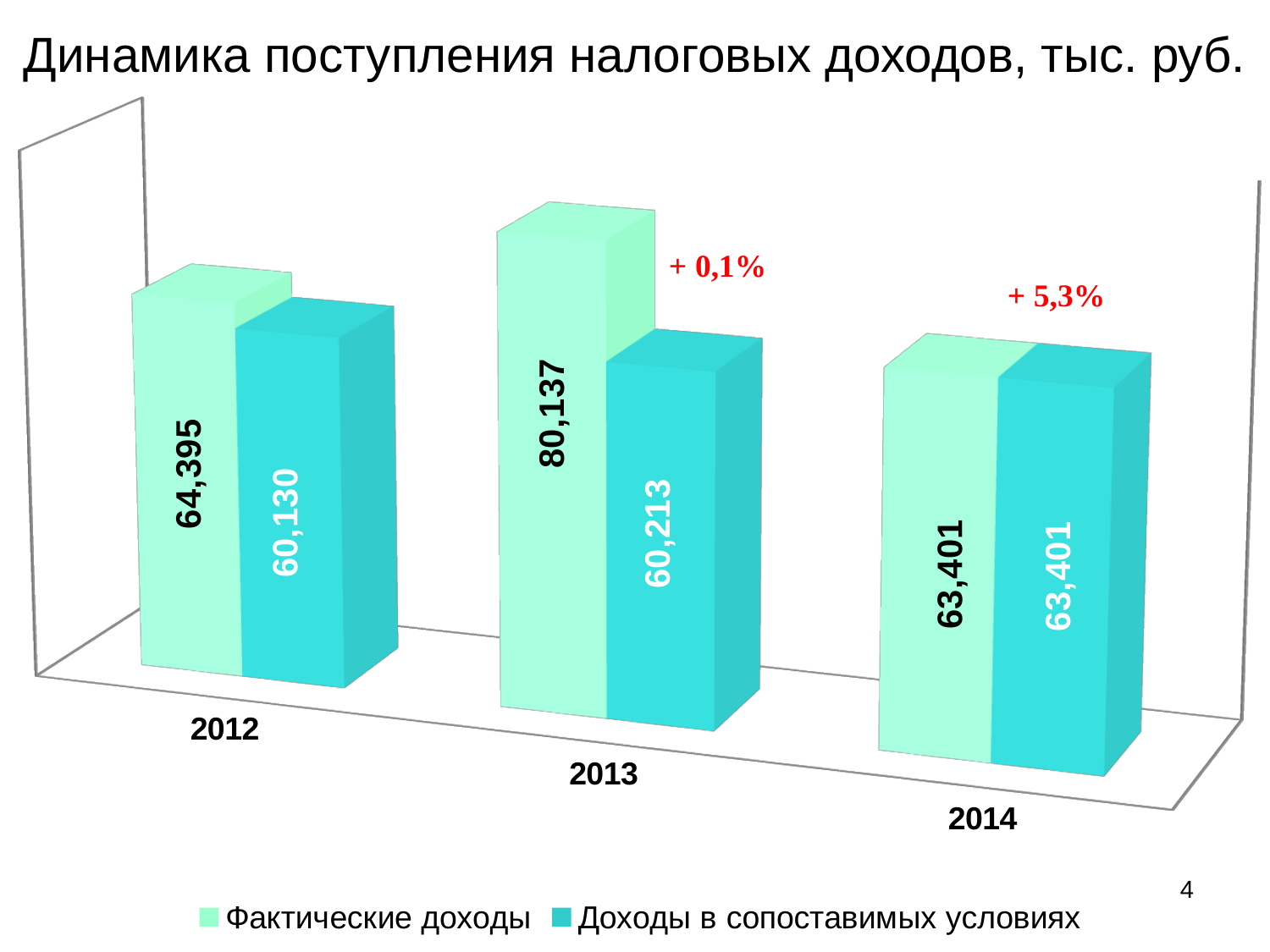
What is the value of Фактические доходы for 2013? 80,137 Which is larger in 2012: Фактические доходы or Доходы в сопоставимых условиях? Фактические доходы How many series does the legend list? 2 What type of chart is shown on the slide? bar chart What is the value of Доходы в сопоставимых условиях for 2013? 60,213 In which year is Фактические доходы the highest? 2013 What is the value of Фактические доходы for 2014? 63,401 What is the value of Доходы в сопоставимых условиях for 2012? 60,130 What is the difference between Фактические доходы and Доходы в сопоставимых условиях in 2013? 19,924 In which year is Фактические доходы the lowest? 2014 In which year is Доходы в сопоставимых условиях the highest? 2014 How many years are shown on the x axis? 3